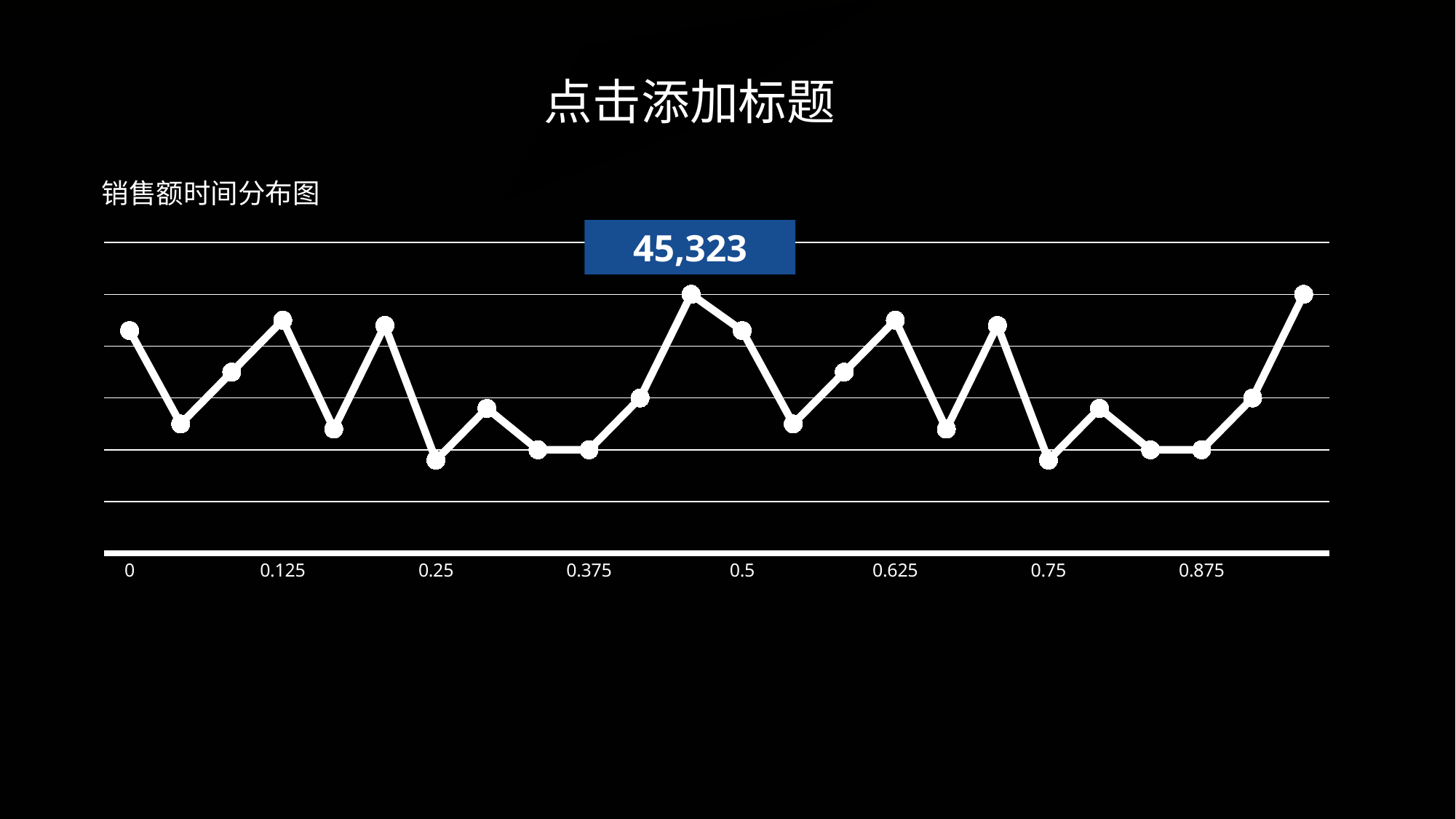
Which is larger, the value at x = 0.625 or the value at x = 0.75? 0.625 What kind of chart is shown on the slide? line chart Do the values rise or fall from x = 0.125 to x = 0.25? fall Which is larger, the value at x = 0.5 or the value at x = 0.875? 0.5 How many data points are plotted on the line? 24 Do the values rise or fall from x = 0.875 to the last point on the right? rise What is the title of the chart? 销售额时间分布图 Which is larger, the value at x = 0.25 or the value at x = 0.5? 0.5 How many lines are plotted on the chart? 1 What value is shown in the blue callout box above the chart's peak? 45,323 How many x-axis tick labels are shown on the chart? 8